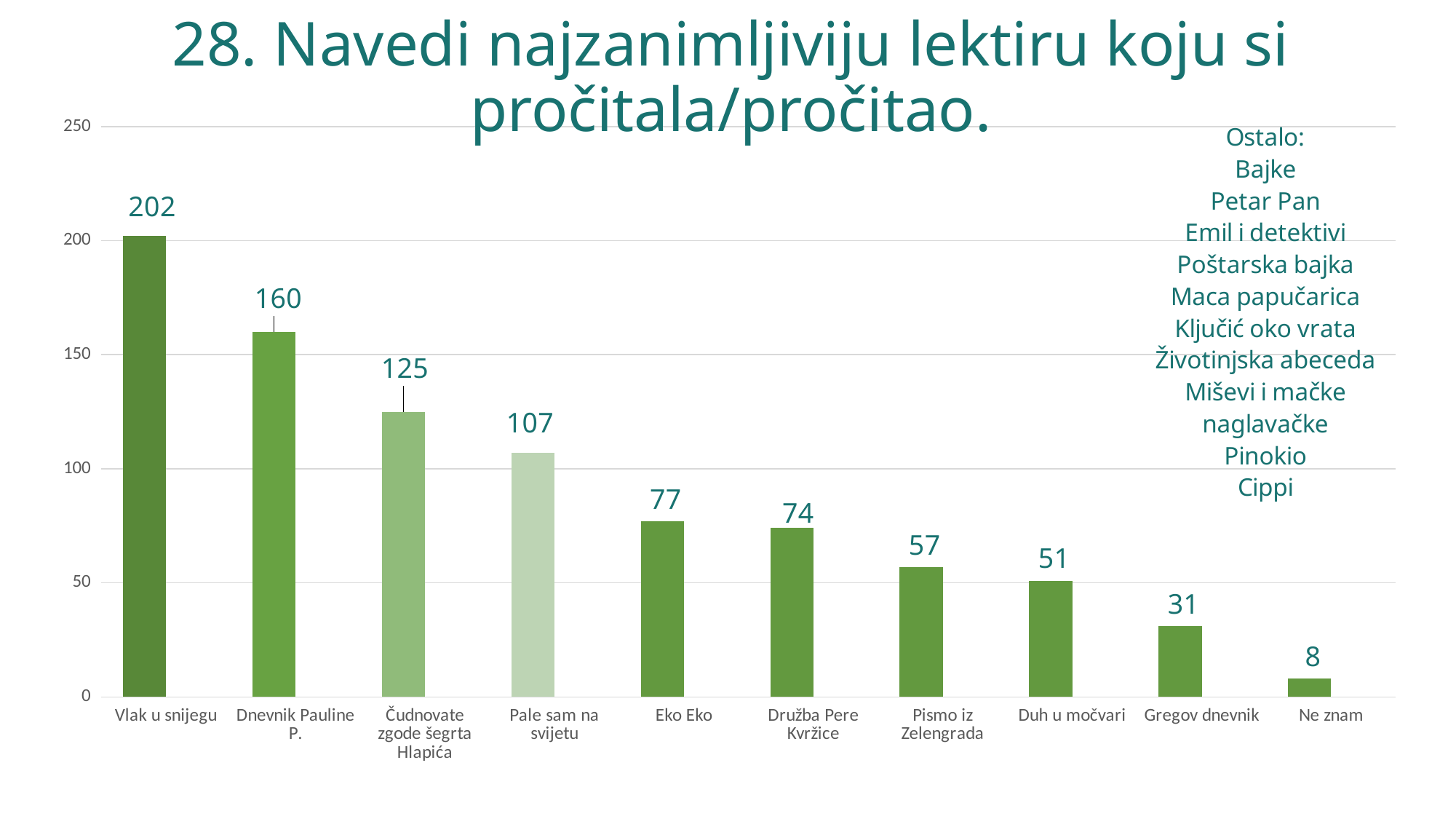
Is the value for Družba Pere Kvržice greater or less than 100? less What is the value for Gregov dnevnik? 31 Which category has the lowest value? Ne znam What is the value for Vlak u snijegu? 202 Which category has the highest value? Vlak u snijegu What is the difference between the values for Pismo iz Zelengrada and Duh u močvari? 6 What kind of chart is shown on the slide? bar chart What is the value for Eko Eko? 77 Do the values rise or fall from left to right along the x axis? fall What is the difference between the values for Vlak u snijegu and Dnevnik Pauline P.? 42 Which is larger, the value for Čudnovate zgode šegrta Hlapića or the value for Pale sam na svijetu? Čudnovate zgode šegrta Hlapića How many categories are shown on the x axis? 10